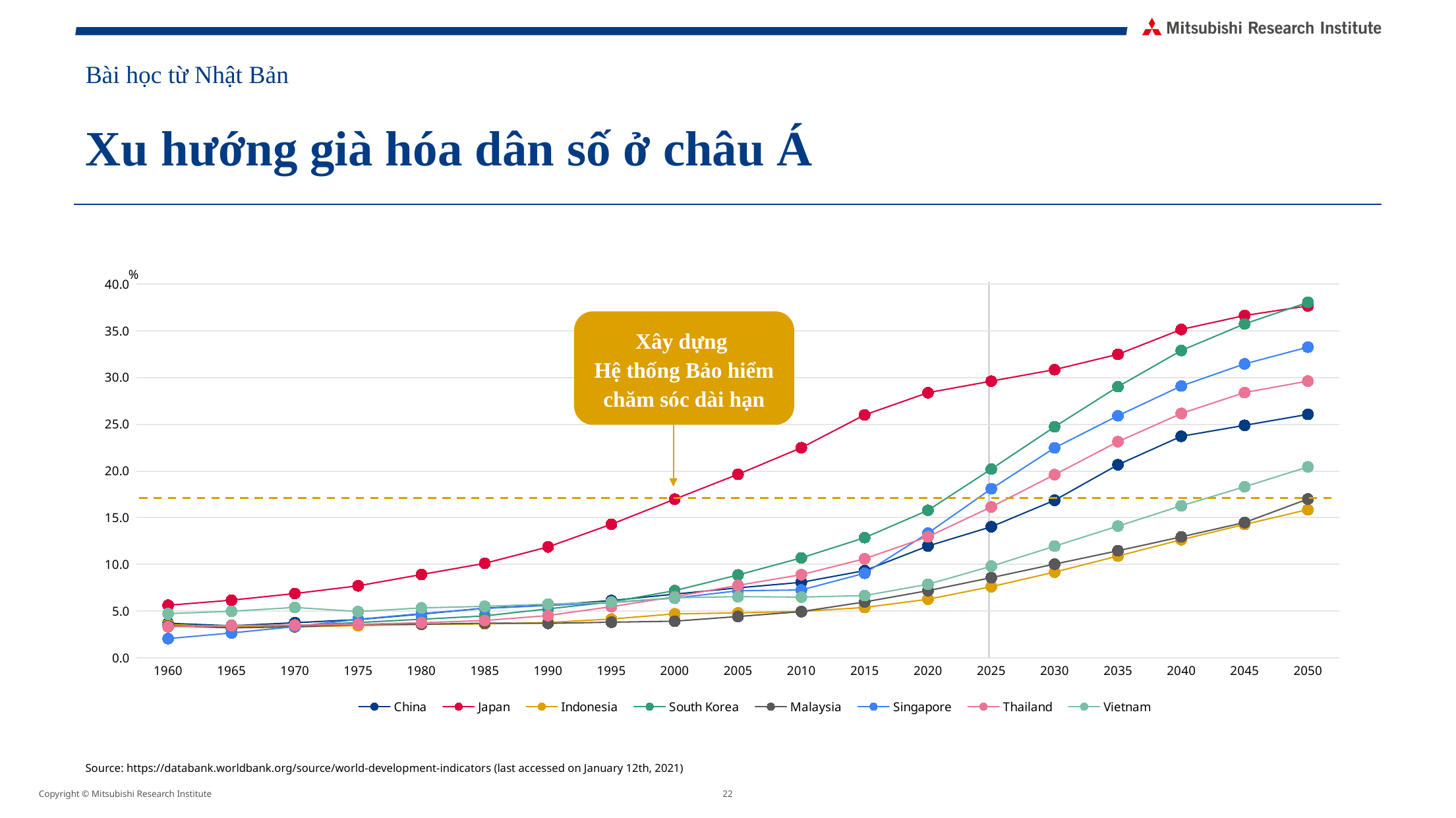
Does the value for Japan rise or fall from 1960 to 2050? rise Is the value for Singapore in 2050 greater or less than 30.0? greater Is the value for Japan in 2000 greater or less than 20.0? less How many series does the legend list? 8 Which country has the highest value in 2025? Japan In 2030, which is larger, the value for Japan or the value for China? Japan In 2040, which is larger, the value for South Korea or the value for Singapore? South Korea Which country has the lowest value in 1960? Singapore How many years are marked along the x axis? 19 What is the first country listed in the legend? China What kind of chart is shown on the slide? line chart Is the value for South Korea in 2050 greater or less than 35.0? greater